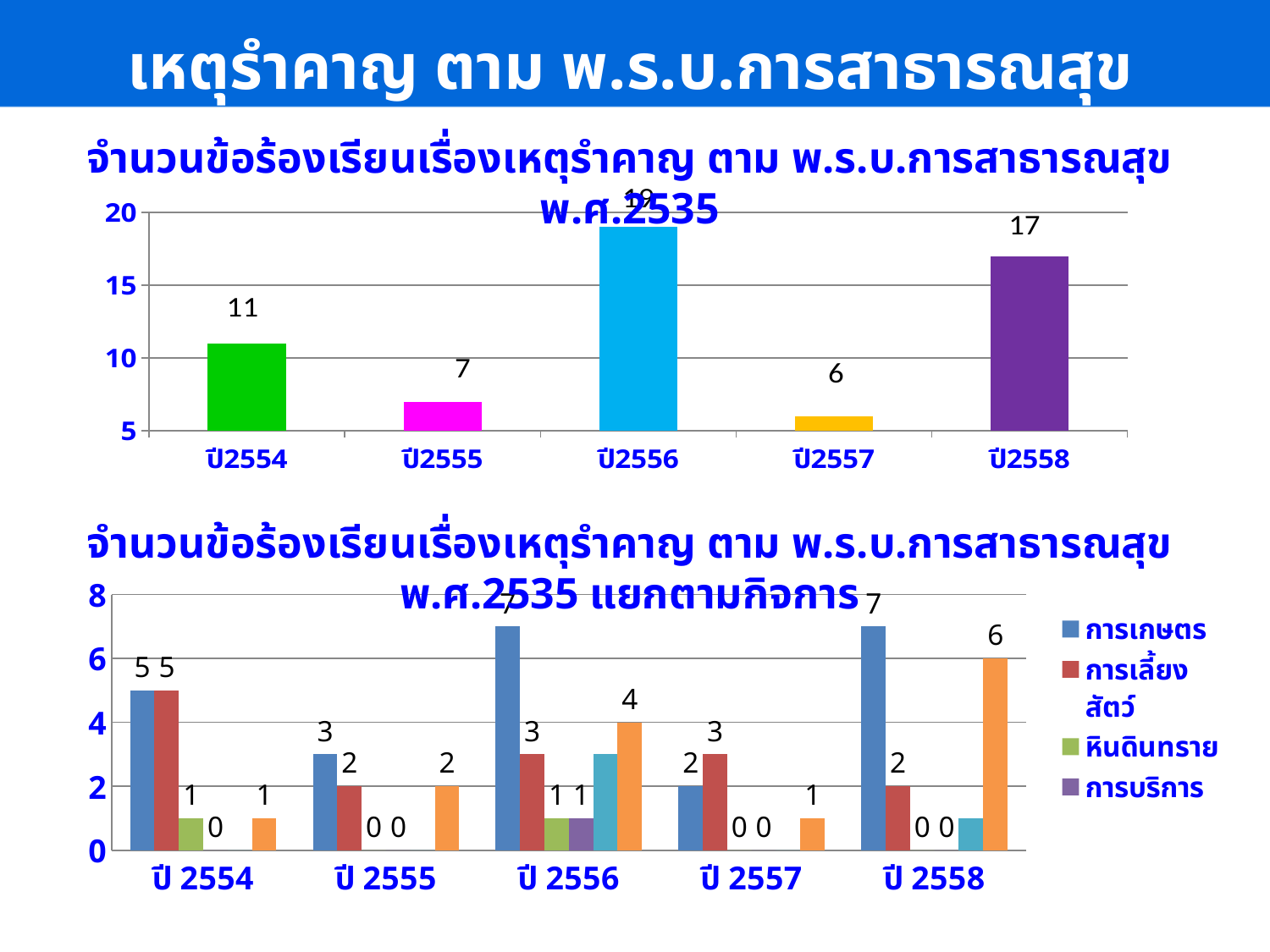
In the top chart, what is the value for ปี2557? 6 In the top chart, what is the value for ปี2556? 19 In the bottom chart, what is the difference between การเกษตร and การเลี้ยงสัตว์ in ปี 2558? 5 In the top chart, how many years are shown on the x axis? 5 In the top chart, which year has the lowest value? ปี2557 In the bottom chart, what is the value for การเกษตร in ปี 2556? 7 In the bottom chart, what is the value for การเลี้ยงสัตว์ in ปี 2554? 5 In the top chart, what is the difference between the values for ปี2558 and ปี2554? 6 In the top chart, which is larger, the value for ปี2554 or ปี2555? ปี2554 What kind of chart is the top chart? bar chart In the bottom chart, which is larger, การเกษตร or การเลี้ยงสัตว์ in ปี 2557? การเลี้ยงสัตว์ In the top chart, which year has the highest value? ปี2556